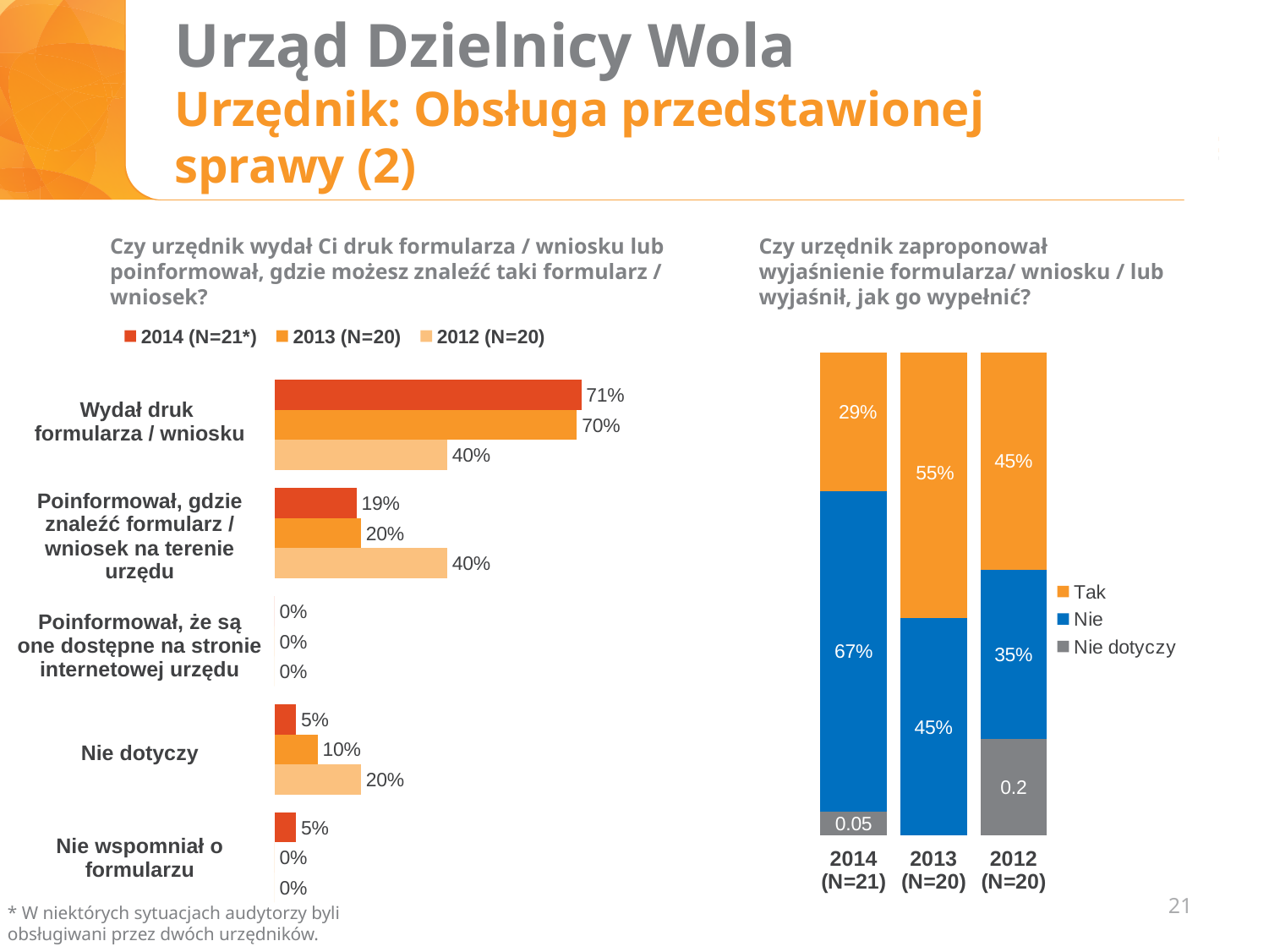
In the left chart, which category has the highest value in the 2014 (N=21*) series? Wydał druk formularza / wniosku In the left chart, how many series does the legend list? 3 In the left chart, how many categories are shown? 5 In the left chart, what is the value for 'Nie dotyczy' in the 2012 (N=20) series? 20% In the left chart, what is the value for 'Wydał druk formularza / wniosku' in the 2014 (N=21*) series? 71% What kind of chart is the chart on the left? Bar chart In the left chart, what is the value for 'Poinformował, gdzie znaleźć formularz / wniosek na terenie urzędu' in the 2013 (N=20) series? 20% In the left chart, what is the difference between the 2014 and 2012 values for 'Wydał druk formularza / wniosku'? 31% In the right chart, what is the 'Tak' value for 2013 (N=20)? 55% In the right chart, which year has the larger 'Tak' value, 2013 (N=20) or 2012 (N=20)? 2013 (N=20) In the right chart, what is the 'Nie' value for 2014 (N=21)? 67% In the right chart, what is the 'Nie dotyczy' value for 2012 (N=20)? 0.2